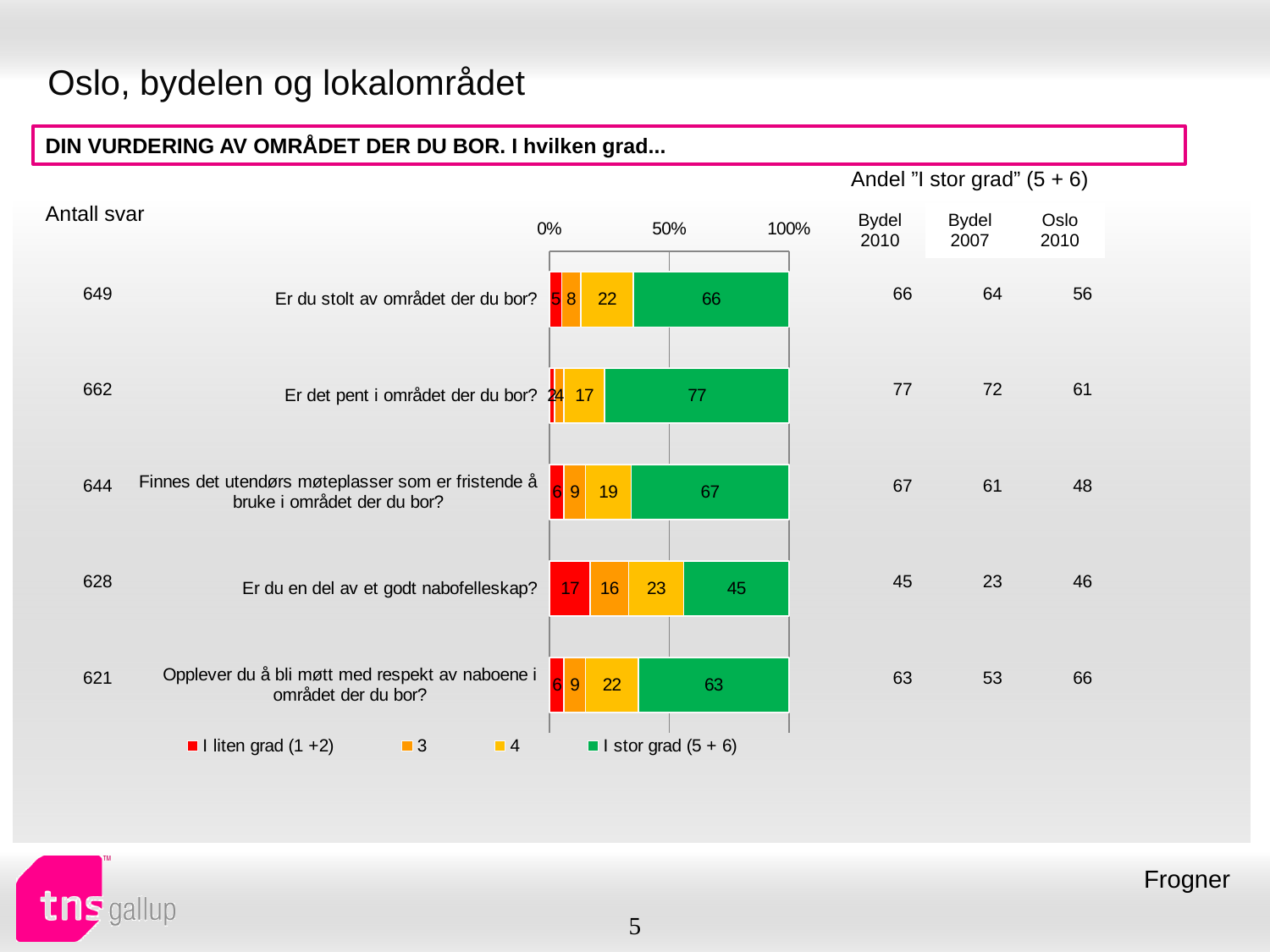
What is the value of "I liten grad (1 +2)" for "Er du en del av et godt nabofelleskap?"? 17 Which category has the highest "I stor grad (5 + 6)" value? Er det pent i området der du bor? What is the value of "I stor grad (5 + 6)" for "Er du stolt av området der du bor?"? 66 Which category has the lowest "I stor grad (5 + 6)" value? Er du en del av et godt nabofelleskap? How many question categories are plotted in the chart? 5 What is the value of "I stor grad (5 + 6)" for "Er det pent i området der du bor?"? 77 What is the difference between the "I stor grad (5 + 6)" values for "Er det pent i området der du bor?" and "Er du en del av et godt nabofelleskap?"? 32 What is the value of series "4" for "Opplever du å bli møtt med respekt av naboene i området der du bor?"? 22 Which is larger: the "I stor grad (5 + 6)" value for "Er du stolt av området der du bor?" or for "Opplever du å bli møtt med respekt av naboene i området der du bor?"? Er du stolt av området der du bor? What kind of chart is shown on the slide? stacked bar chart How many series does the chart legend list? 4 Which legend entry is shown in green? I stor grad (5 + 6)